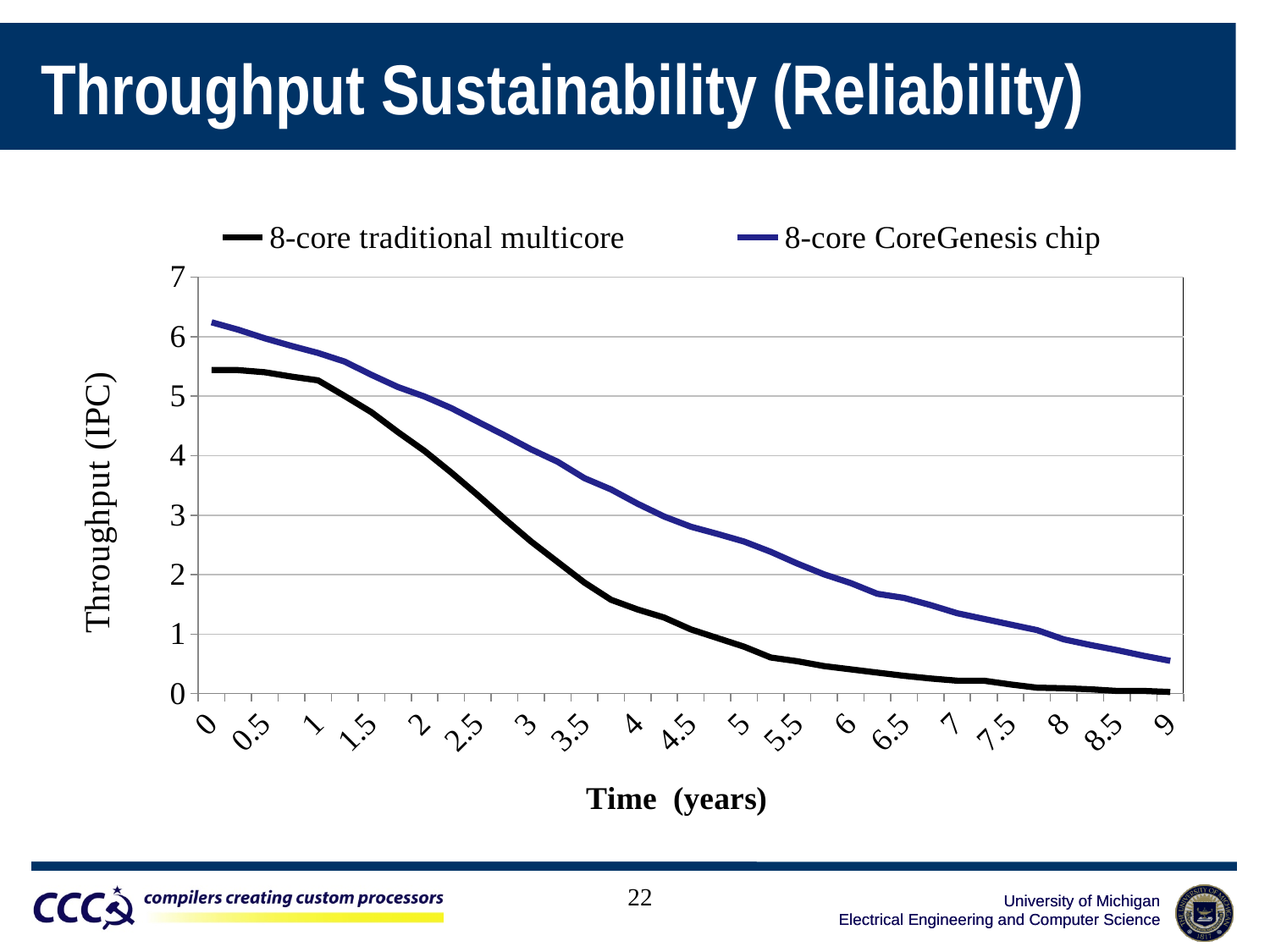
Does the throughput of the 8-core CoreGenesis chip rise or fall over time? fall How many time points are marked along the x axis? 19 Is the throughput of the 8-core CoreGenesis chip at time 9 greater or less than 1? less What is the label of the y axis? Throughput (IPC) At time 0, which series has the higher throughput? 8-core CoreGenesis chip Is the throughput of the 8-core traditional multicore at time 0 greater or less than 5? greater At time 4 years, which series has the higher throughput? 8-core CoreGenesis chip Does the throughput of the 8-core traditional multicore rise or fall as time increases? fall Is the throughput of the 8-core traditional multicore at time 4 greater or less than 2? less What kind of chart is shown on the slide? line chart How many series does the legend list? 2